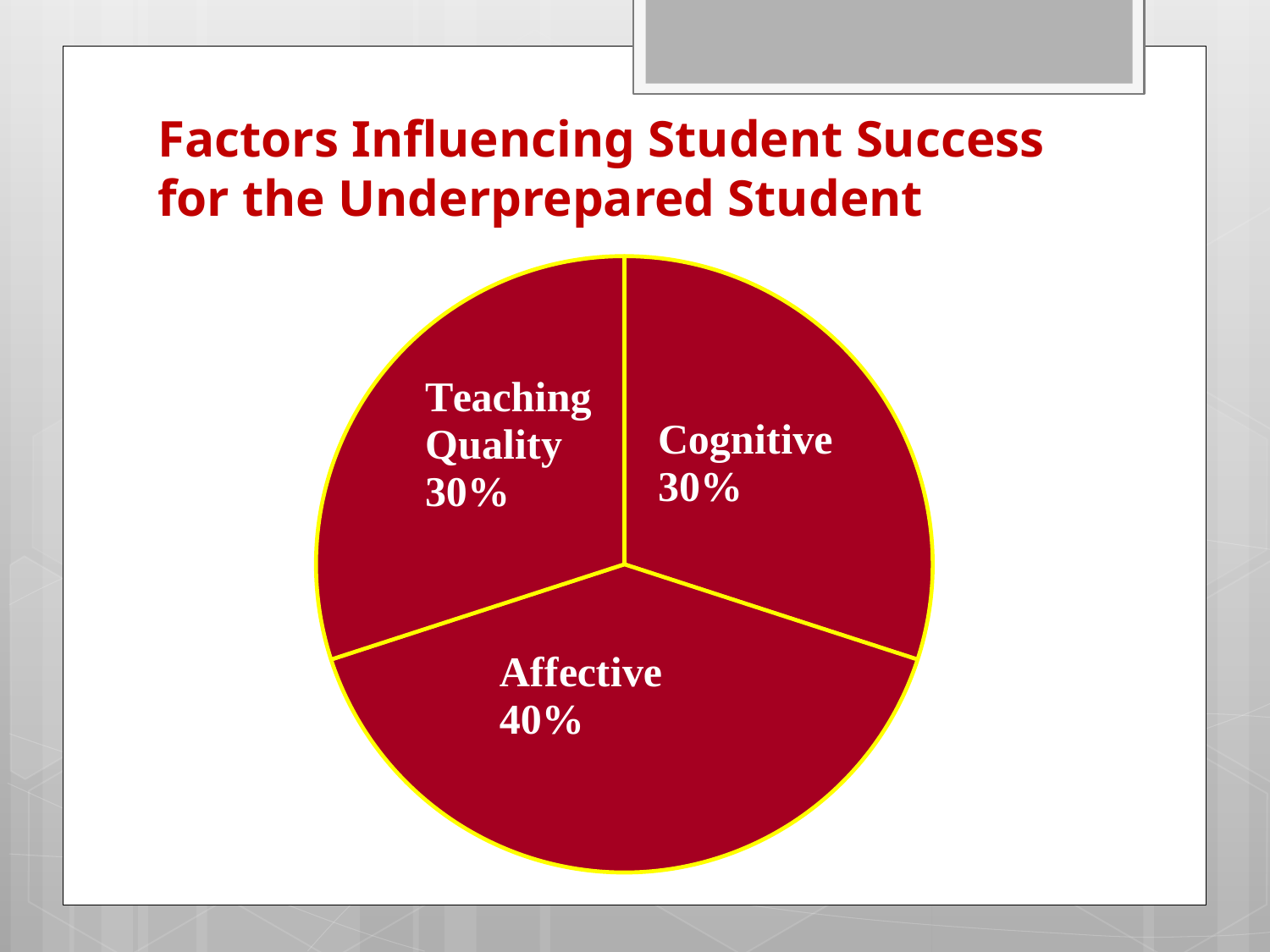
Which factor has the largest slice of the pie? Affective What is the difference between the Affective share and the Cognitive share? 10% What kind of chart is shown on the slide? pie chart Which is larger, the Affective slice or the Teaching Quality slice? Affective How many slices does the pie chart have? 3 What is the title of the slide containing the pie chart? Factors Influencing Student Success for the Underprepared Student What colour are the slices of the pie chart? dark red What share of the pie does Cognitive account for? 30% What share of the pie does Teaching Quality account for? 30% What is the combined share of Teaching Quality and Cognitive? 60% What share of the pie does Affective account for? 40%